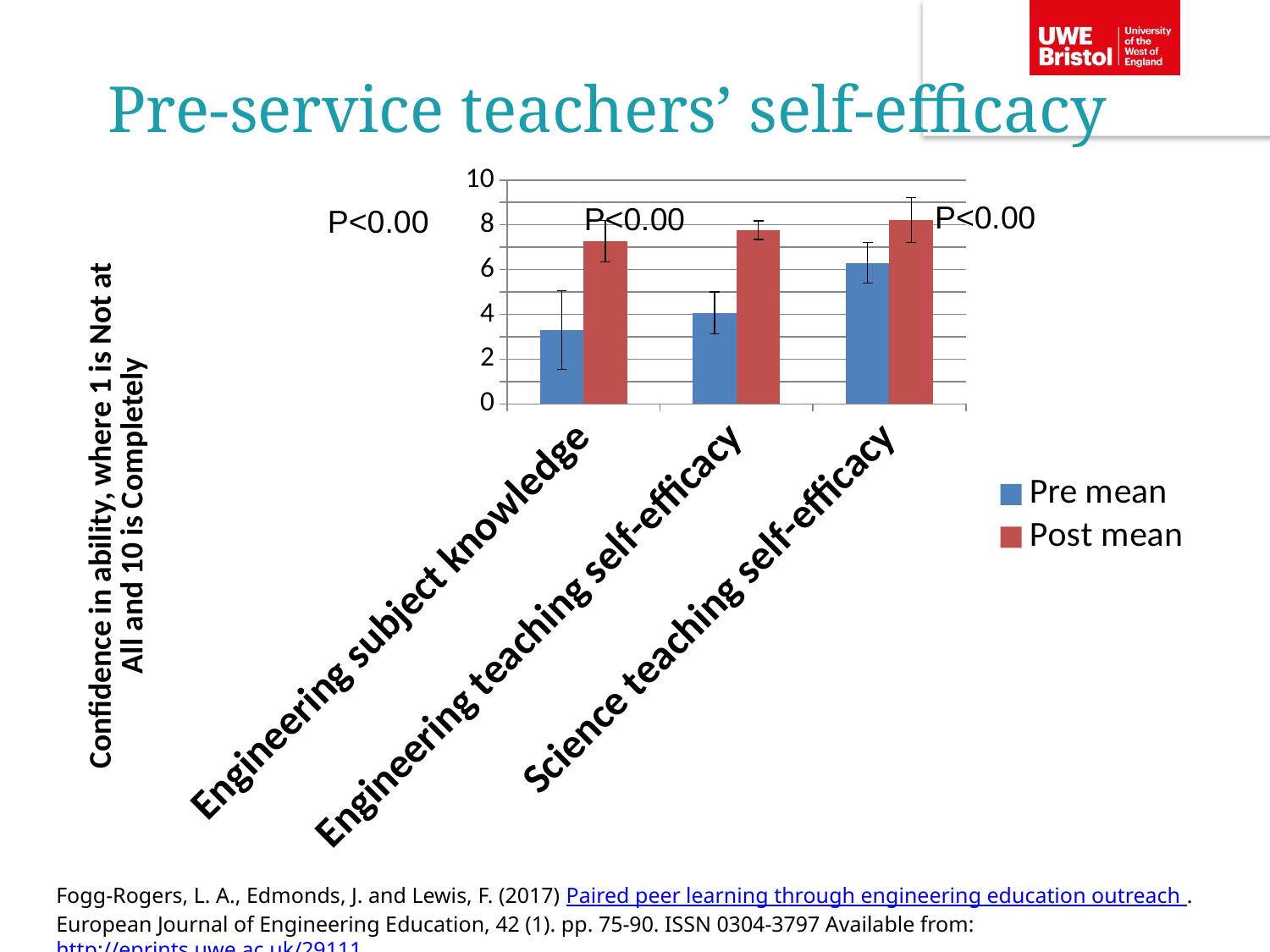
What colour are the Post mean bars in the chart? Red How many series does the chart's legend list? 2 Which series has the larger value for Science teaching self-efficacy, Pre mean or Post mean? Post mean Which category has the highest Pre mean value? Science teaching self-efficacy Is the Post mean value for Engineering teaching self-efficacy greater or less than 6? greater How many categories are shown on the x axis of the chart? 3 What kind of chart is shown on the slide? Bar chart Which series has the larger value for Engineering subject knowledge, Pre mean or Post mean? Post mean Is the Post mean value for Engineering subject knowledge greater or less than 6? greater Which category has the lowest Pre mean value? Engineering subject knowledge Is the Pre mean value for Engineering subject knowledge greater or less than 4? less What is the label on the vertical axis of the chart? Confidence in ability, where 1 is Not at All and 10 is Completely